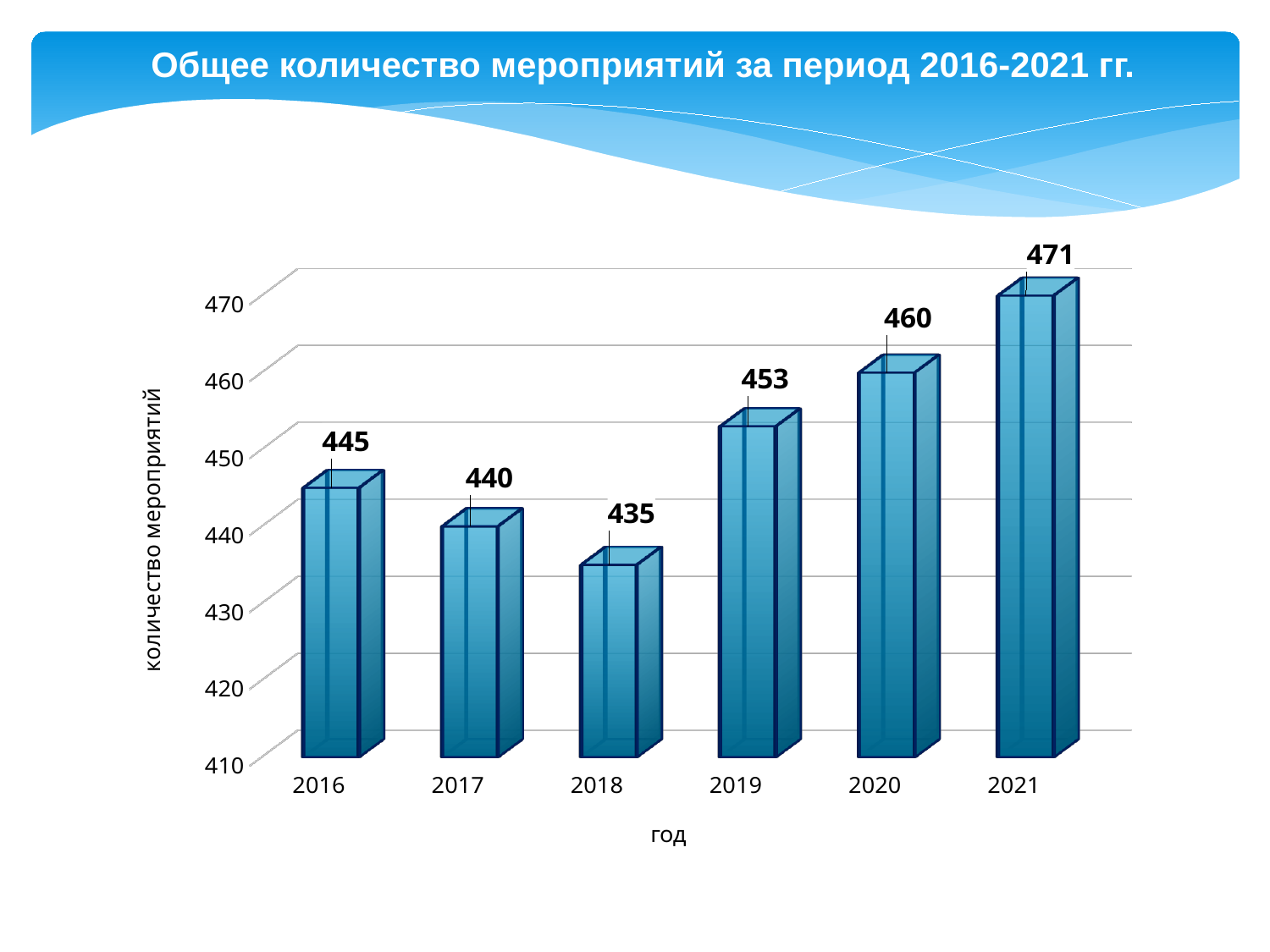
Is the value for 2020 greater or less than 450? greater How many years are shown on the x axis? 6 What is the difference between the values for 2019 and 2018? 18 What is the value for 2018? 435 What is the difference between the values for 2021 and 2016? 26 What is the title of the chart? Общее количество мероприятий за период 2016-2021 гг. Which is larger, the value for 2017 or the value for 2019? 2019 What is the value for 2016? 445 Which year has the lowest value? 2018 What kind of chart is shown on the slide? bar chart Which year has the highest value? 2021 What is the value for 2020? 460